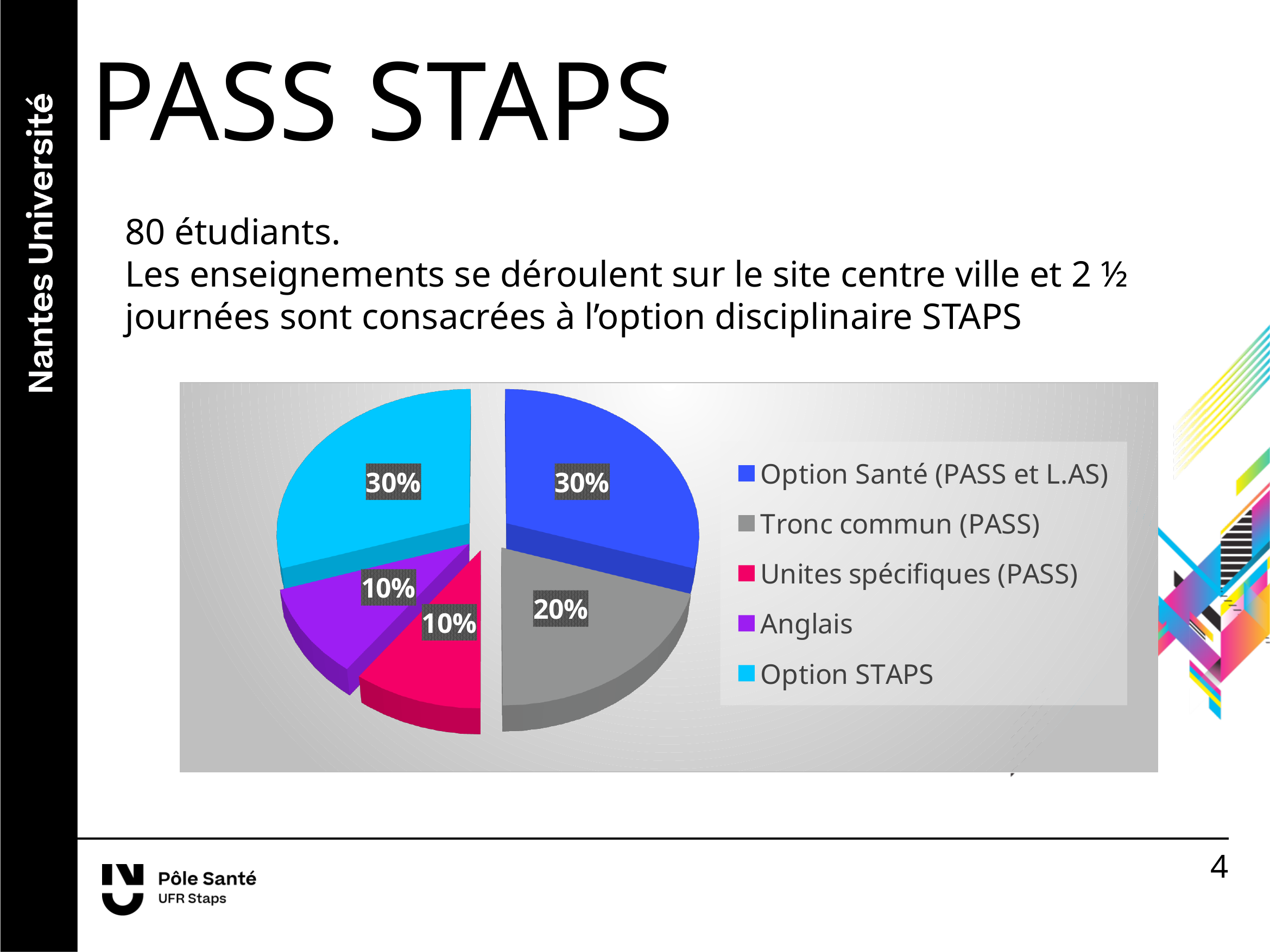
What percentage of the pie chart is Unites spécifiques (PASS)? 10% Which is larger in the pie chart, Tronc commun (PASS) or Anglais? Tronc commun (PASS) What percentage of the pie chart is Anglais? 10% What percentage of the pie chart is Option Santé (PASS et L.AS)? 30% How many slices does the pie chart have? 5 What percentage of the pie chart is Tronc commun (PASS)? 20% What colour is the Option STAPS slice in the pie chart? Cyan (light blue) What kind of chart is shown on the slide? Pie chart What is the difference in percentage points between Tronc commun (PASS) and Anglais? 10 percentage points Which is larger in the pie chart, Option STAPS or Unites spécifiques (PASS)? Option STAPS What share of the pie does Option STAPS represent? 30% What is the difference in percentage points between Option Santé (PASS et L.AS) and Tronc commun (PASS)? 10 percentage points